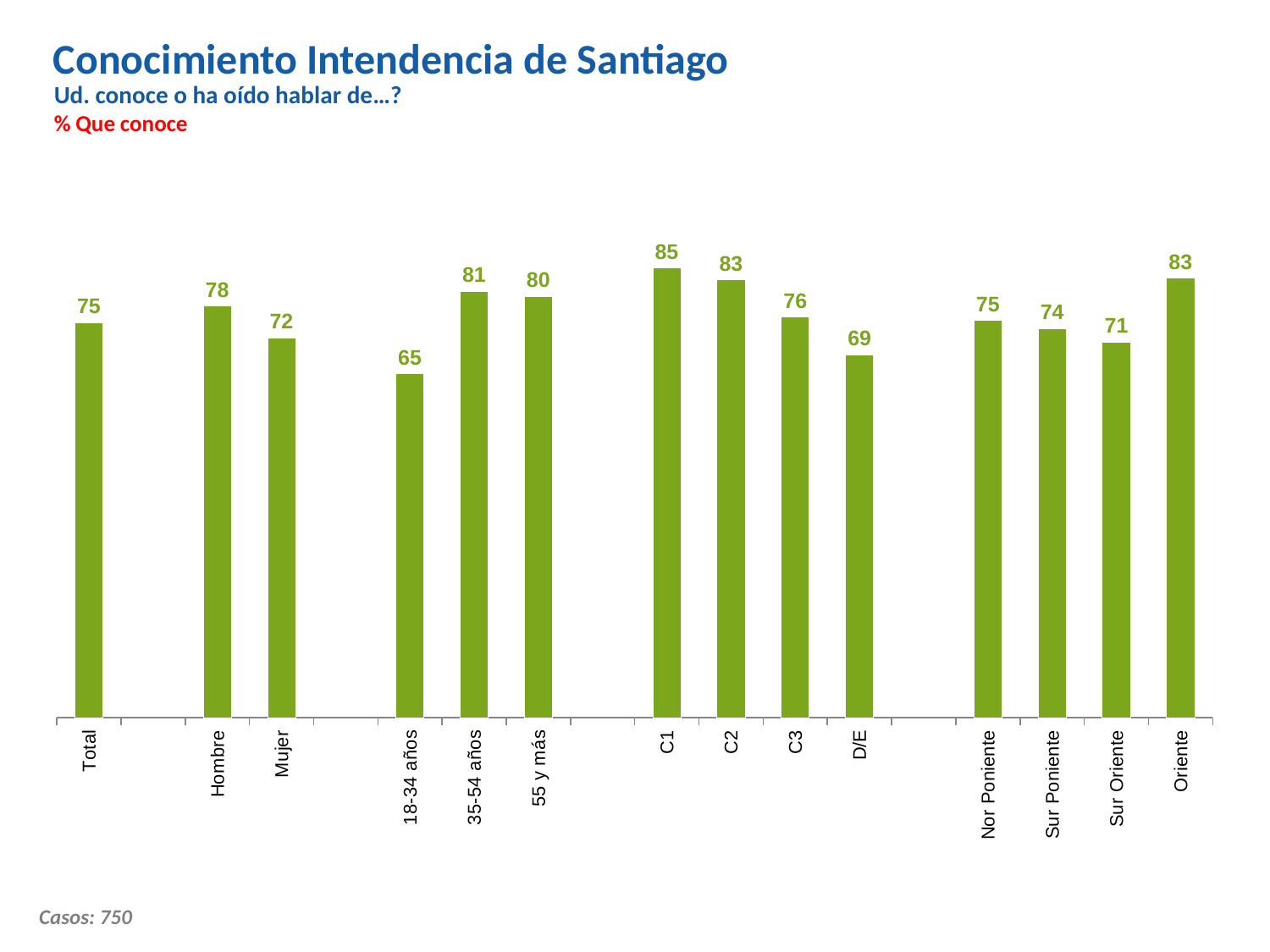
What is the value for D/E? 69 What is the title of the chart? Conocimiento Intendencia de Santiago What is the difference between the values for Hombre and Mujer? 6 Which category has the lowest value? 18-34 años What kind of chart is shown on the slide? Bar chart What is the value for Mujer? 72 How many categories are plotted in the chart? 15 What is the value for 18-34 años? 65 Which category has the highest value? C1 What is the value for Total? 75 What is the difference between the values for C1 and D/E? 16 Which is larger, the value for Oriente or the value for Sur Oriente? Oriente